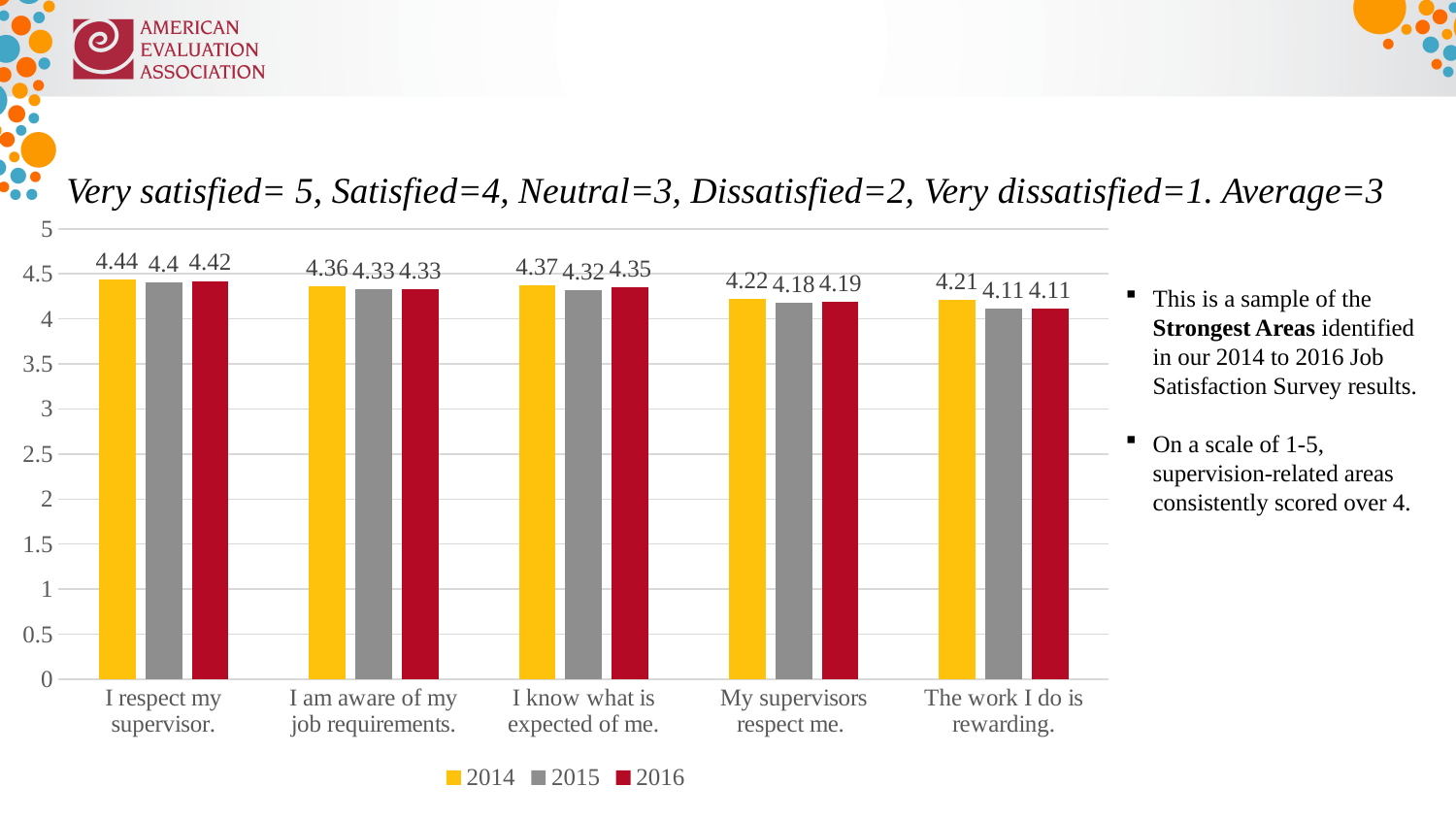
What kind of chart is shown on the slide? Bar chart What is the 2015 value for "The work I do is rewarding."? 4.11 What is the difference between the 2014 and 2015 values for "The work I do is rewarding."? 0.1 Which colour represents the 2016 series in the legend? Red Which category has the lowest 2016 value? The work I do is rewarding. Which category has the highest 2014 value? I respect my supervisor. Which is larger for "I know what is expected of me.": the 2014 value or the 2015 value? 2014 What is the 2014 value for "I respect my supervisor."? 4.44 How many categories are shown on the x axis? 5 Is the 2015 value for "My supervisors respect me." greater or less than 4? greater What is the 2016 value for "My supervisors respect me."? 4.19 How many series does the legend list? 3